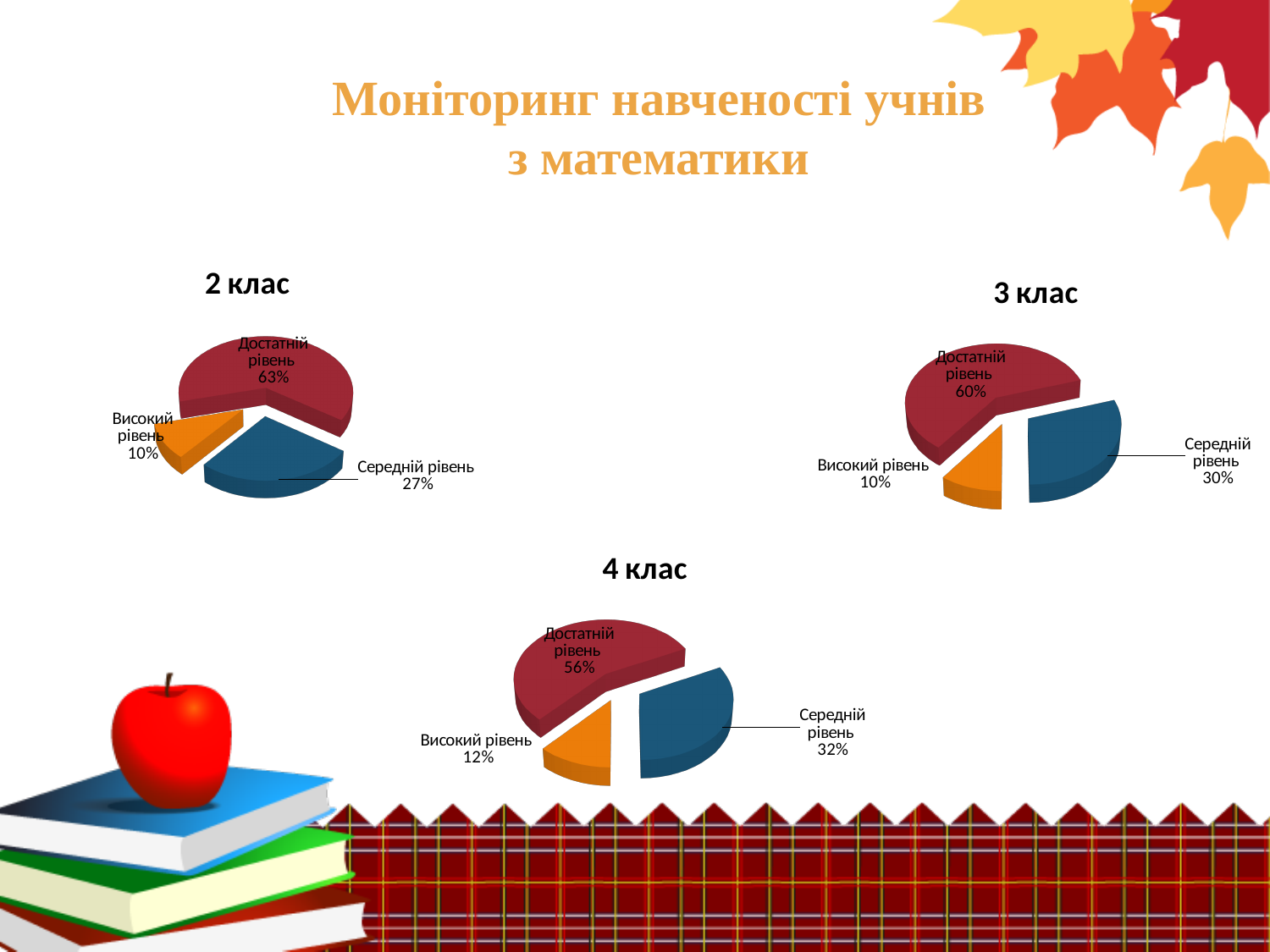
In the "4 клас" chart, which level has the largest slice? Достатній рівень In the "3 клас" chart, what share is labelled for Середній рівень? 30% In the "2 клас" chart, what share is labelled for Достатній рівень? 63% In the "4 клас" chart, what share is labelled for Достатній рівень? 56% Which is larger in the "4 клас" chart: the Середній рівень share or the Високий рівень share? Середній рівень In the "3 клас" chart, what is the difference between the Достатній рівень share and the Середній рівень share? 30% In the "2 клас" chart, what share is labelled for Середній рівень? 27% In the "2 клас" chart, which level has the smallest slice? Високий рівень In the "4 клас" chart, what share is labelled for Високий рівень? 12% How many slices does the "3 клас" chart have? 3 What type of chart is used for "2 клас"? Pie chart In the "3 клас" chart, what share is labelled for Високий рівень? 10%